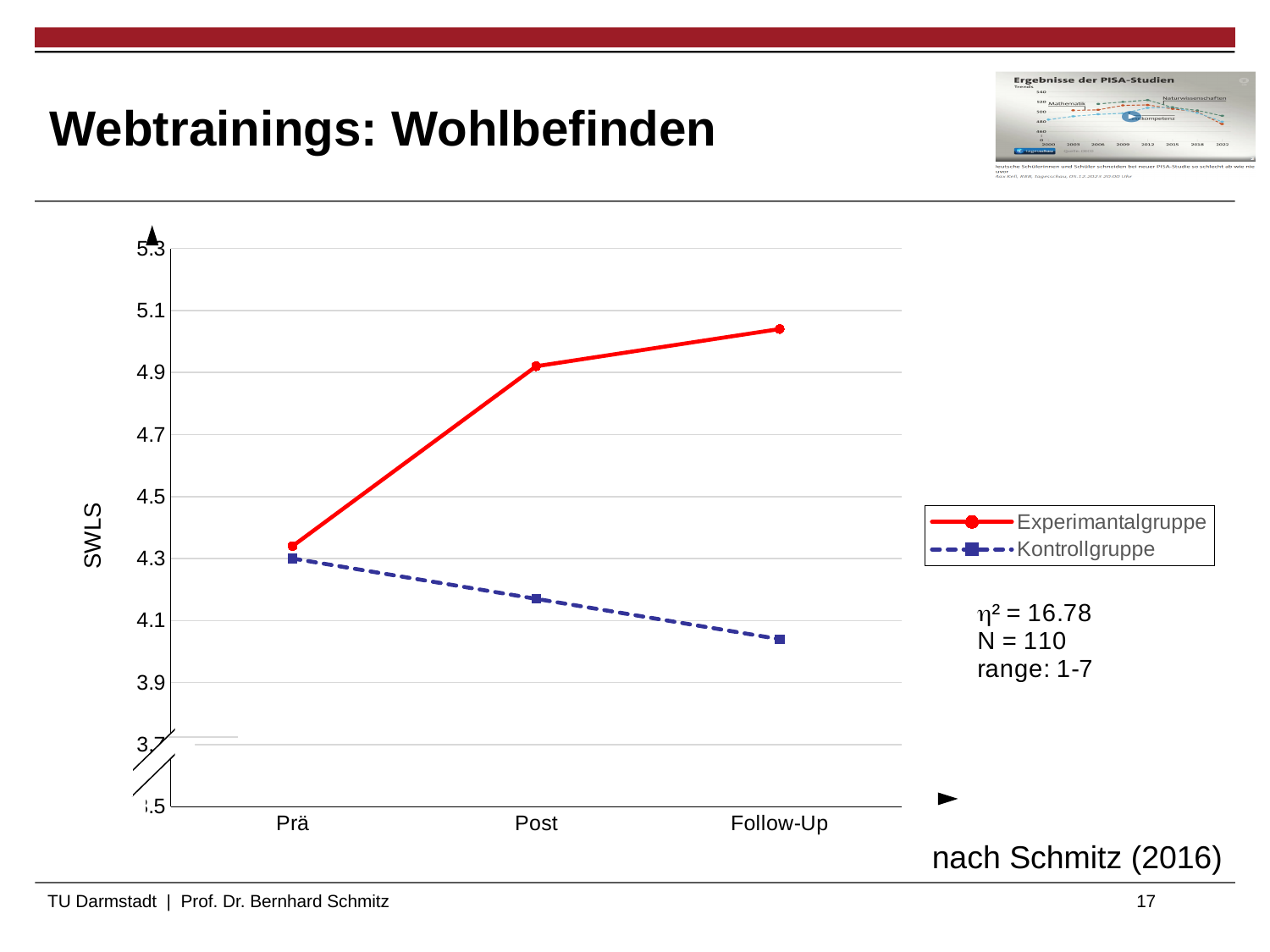
How many measurement points are shown along the x axis? 3 How many series does the legend list? 2 What kind of chart is shown on the slide? line chart Do the values for Experimantalgruppe rise or fall from Prä to Follow-Up? rise At which measurement point does Experimantalgruppe reach its highest value? Follow-Up At which measurement point does Kontrollgruppe have its lowest value? Follow-Up Is the value for Kontrollgruppe at Follow-Up greater or less than 4.3? less Is the value for Experimantalgruppe at Post greater or less than 4.7? greater Do the values for Kontrollgruppe rise or fall from Prä to Follow-Up? fall Is the value for Experimantalgruppe at Follow-Up greater or less than 4.9? greater At Follow-Up, which series has the higher value, Experimantalgruppe or Kontrollgruppe? Experimantalgruppe What is the label on the y axis of the chart? SWLS